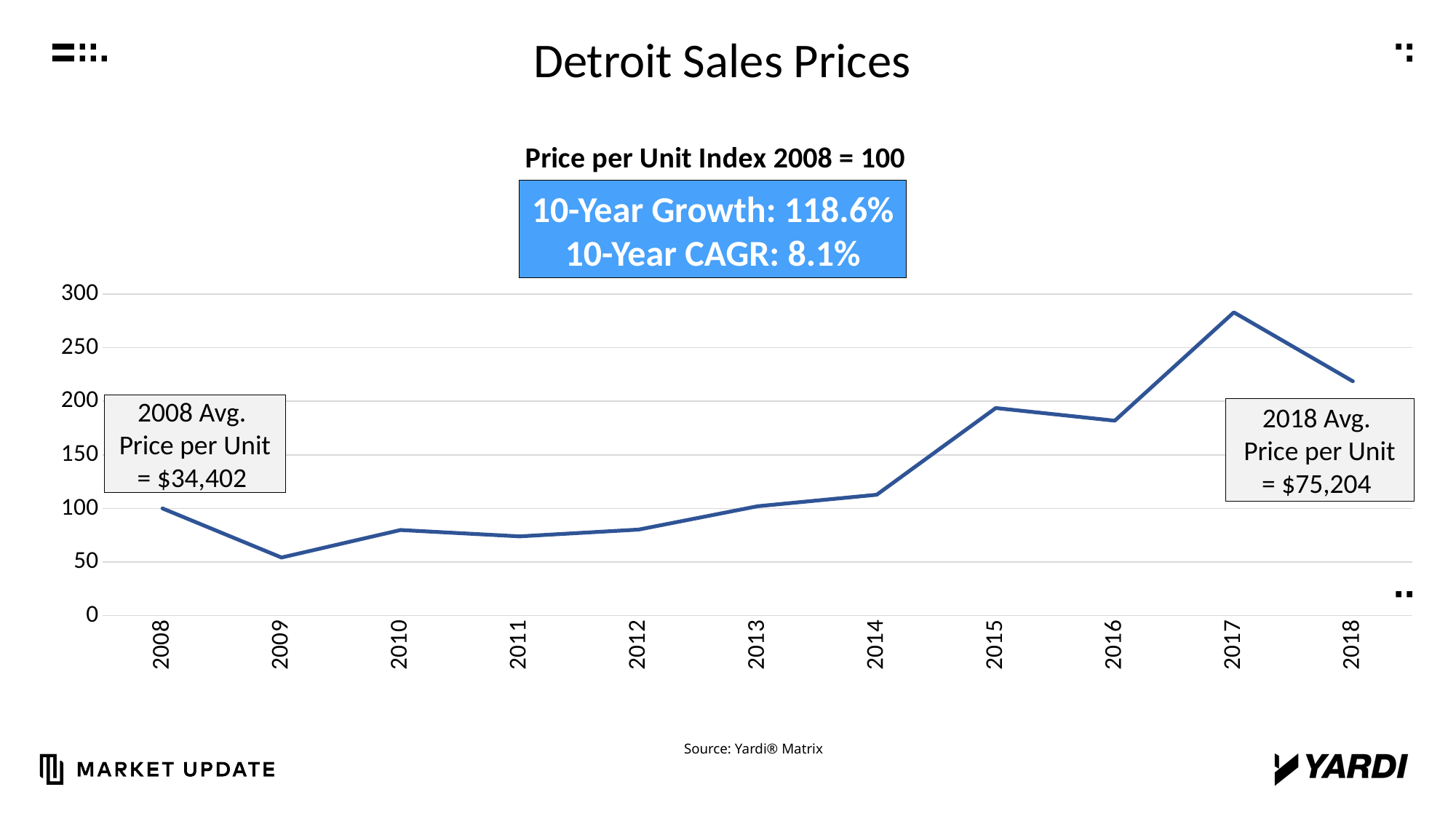
According to the slide, what was the 2018 average price per unit in Detroit? $75,204 What is the Price per Unit Index value for 2008? 100 What kind of chart is shown on the slide? line chart Is the Price per Unit Index for 2017 greater or less than 250? greater In which year is the Price per Unit Index at its lowest? 2009 Which year has a higher Price per Unit Index, 2017 or 2018? 2017 How many years are plotted along the x axis of the chart? 11 What 10-Year Growth figure is shown on the slide? 118.6% Does the Price per Unit Index rise or fall from 2014 to 2017? rise Is the Price per Unit Index for 2015 greater or less than 150? greater In which year does the Price per Unit Index reach its highest value? 2017 Is the Price per Unit Index for 2010 greater or less than 100? less